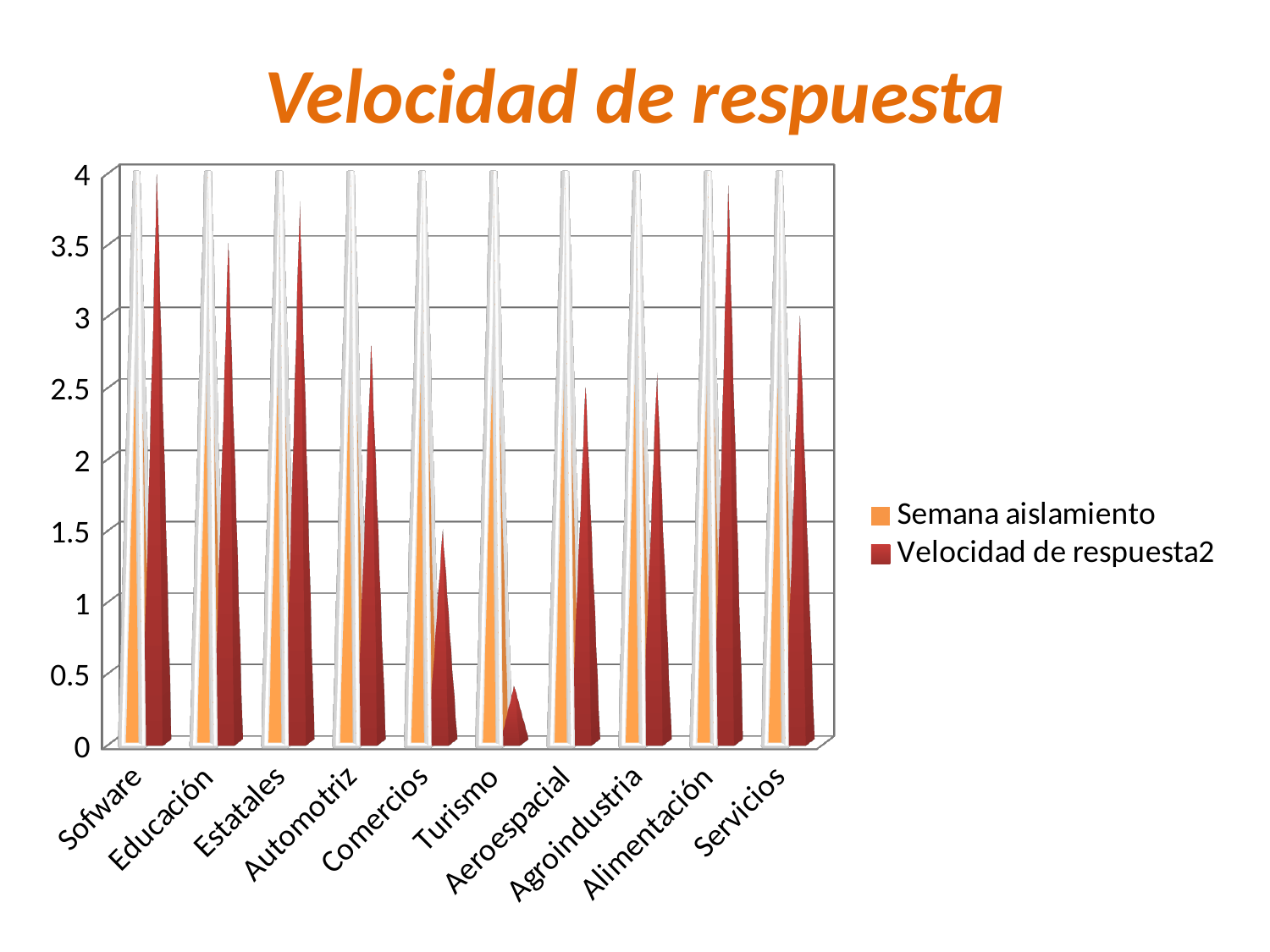
Is the Velocidad de respuesta2 value for Aeroespacial greater or less than 3? less Which has the larger Velocidad de respuesta2 value, Comercios or Turismo? Comercios How many categories are shown on the x axis? 10 Which series is shown in orange in the legend? Semana aislamiento Is the Velocidad de respuesta2 value for Turismo greater or less than 1? less What is the title of the chart? Velocidad de respuesta Which has the larger Velocidad de respuesta2 value, Estatales or Automotriz? Estatales Which category has the lowest value for Velocidad de respuesta2? Turismo How many series does the legend list? 2 What kind of chart is shown on the slide? bar chart Is the Velocidad de respuesta2 value for Comercios greater or less than 2? less